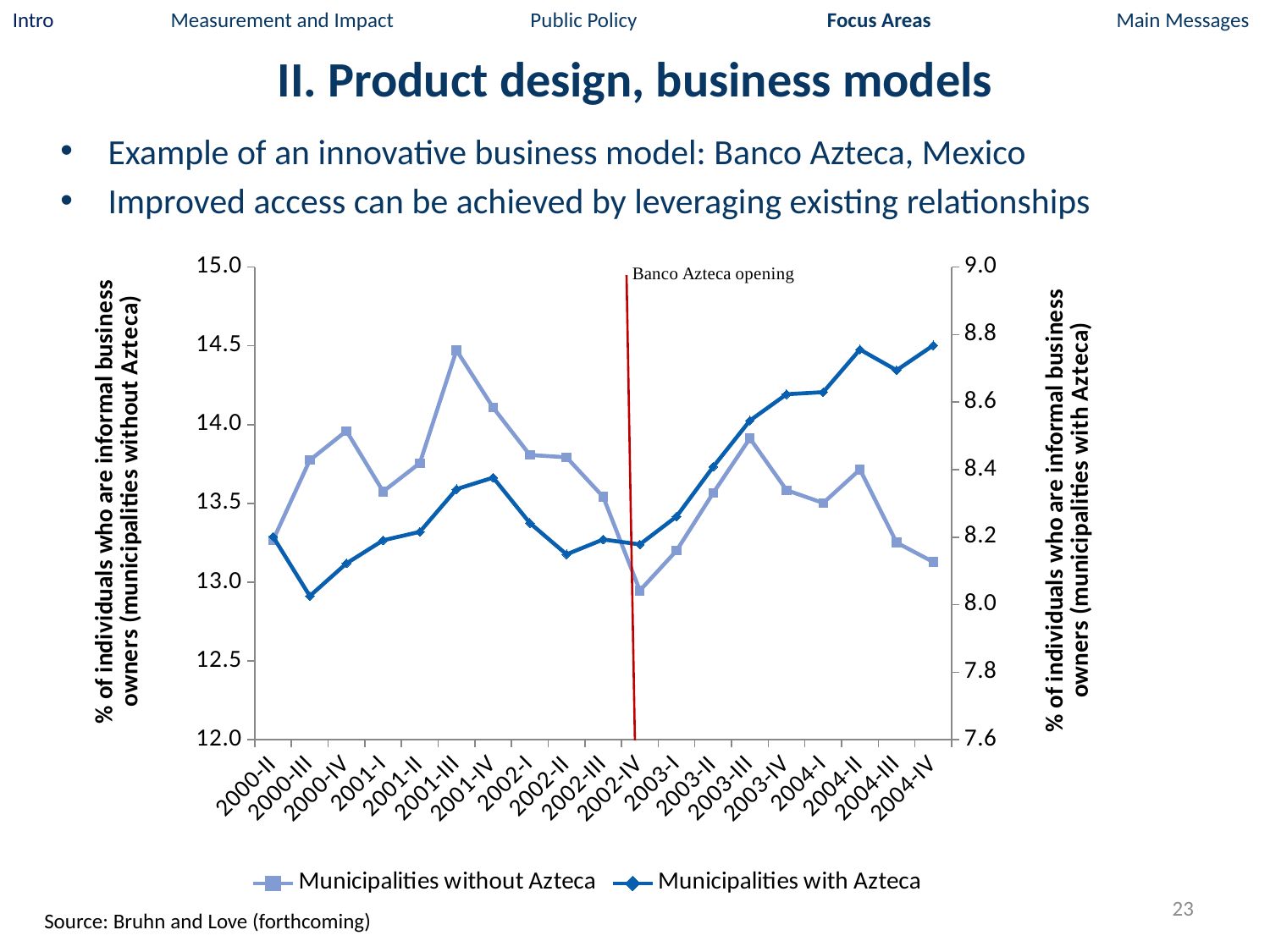
Does the 'Municipalities with Azteca' series rise or fall from 2002-IV to 2004-IV? rise Is the value for 'Municipalities with Azteca' in 2004-IV greater or less than 8.6? greater How many time periods are plotted along the x axis? 19 In which period does the 'Municipalities without Azteca' series reach its highest value? 2001-III How many series does the legend list? 2 What event does the red vertical line on the chart mark? Banco Azteca opening What kind of chart is shown on the slide? line chart Is the value for 'Municipalities with Azteca' in 2000-III greater or less than 8.2? less In which period does the 'Municipalities without Azteca' series reach its lowest value? 2002-IV Is the value for 'Municipalities without Azteca' in 2001-III greater or less than 14.0? greater For 'Municipalities without Azteca', which period has the larger value: 2000-II or 2001-III? 2001-III In which period does the 'Municipalities with Azteca' series reach its lowest value? 2000-III